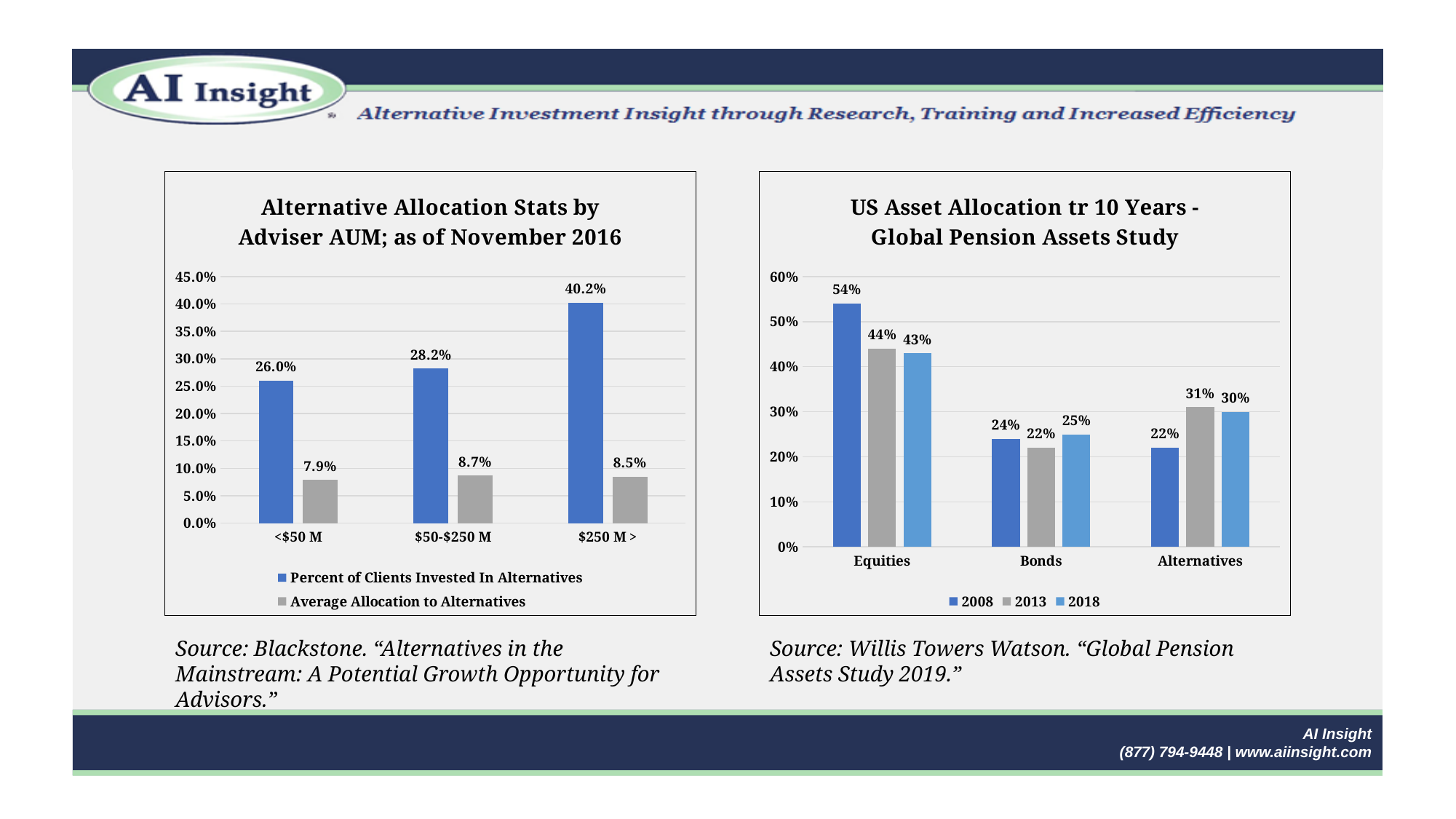
In the 'Alternative Allocation Stats by Adviser AUM' chart, which AUM category has the lowest Average Allocation to Alternatives? <$50 M In the 'US Asset Allocation tr 10 Years' chart, what was the allocation to Alternatives in 2018? 30% In the 'US Asset Allocation tr 10 Years' chart, which is larger: the Bonds allocation in 2018 or the Alternatives allocation in 2008? Bonds allocation in 2018 In the 'Alternative Allocation Stats by Adviser AUM' chart, which AUM category has the highest Percent of Clients Invested In Alternatives? $250 M > In the 'US Asset Allocation tr 10 Years' chart, which asset class had the highest allocation in 2013? Equities In the 'Alternative Allocation Stats by Adviser AUM' chart, what is the Average Allocation to Alternatives for the $50-$250 M category? 8.7% In the 'Alternative Allocation Stats by Adviser AUM' chart, what is the Percent of Clients Invested In Alternatives for the $250 M > category? 40.2% In the 'US Asset Allocation tr 10 Years' chart, what was the allocation to Equities in 2008? 54% In the 'Alternative Allocation Stats by Adviser AUM' chart, what is the difference between the Percent of Clients Invested In Alternatives for $250 M > and for <$50 M? 14.2% In the 'US Asset Allocation tr 10 Years' chart, what is the difference between the Equities allocation in 2008 and in 2018? 11% In the 'Alternative Allocation Stats by Adviser AUM' chart, how many series does the legend list? 2 What type of chart is the 'US Asset Allocation tr 10 Years' chart? Bar chart